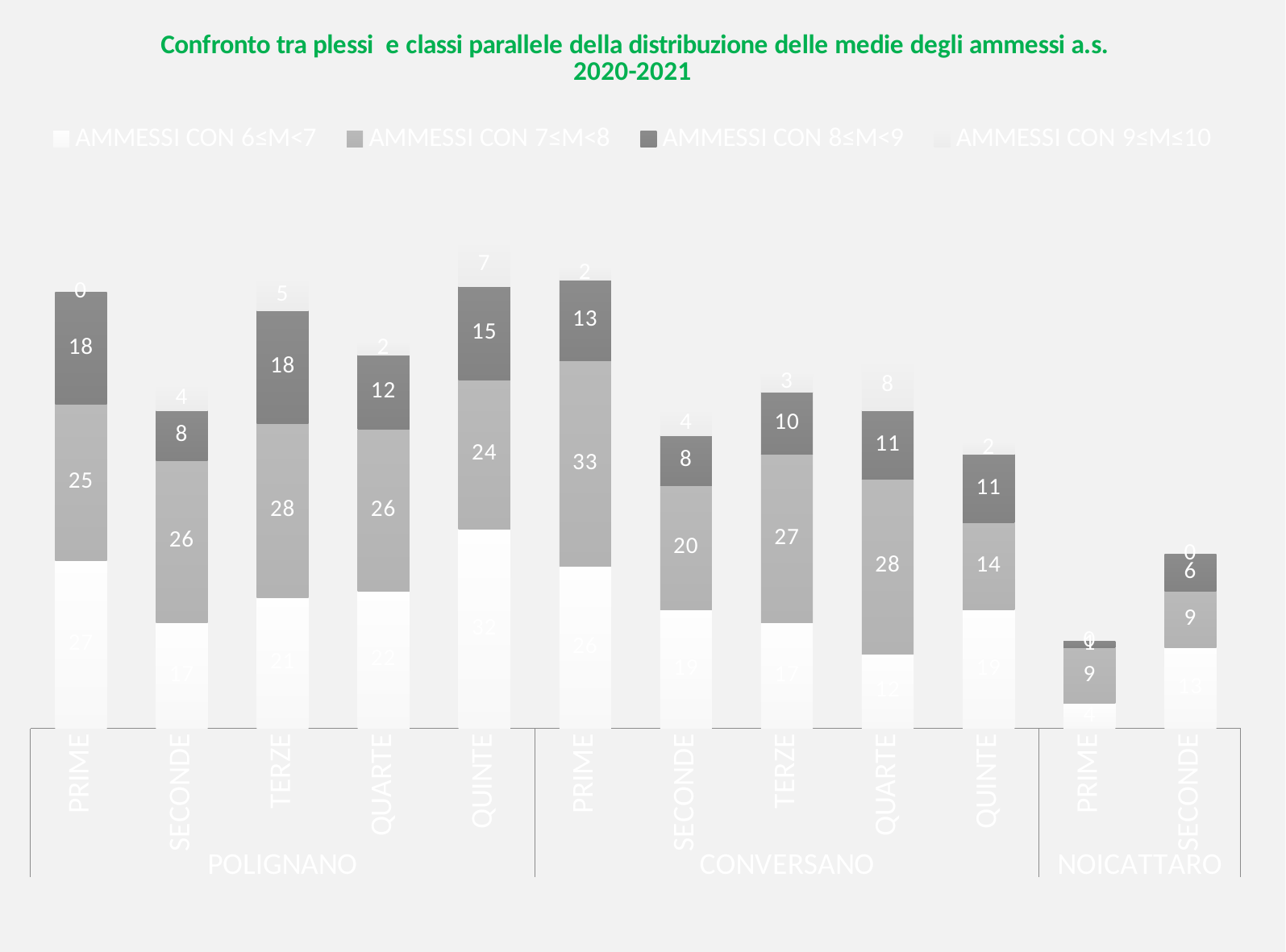
Which bar has the lowest total in the chart? PRIME in NOICATTARO In the CONVERSANO group, what is the value of AMMESSI CON 7≤M<8 for PRIME? 33 In the POLIGNANO group, what is the value of AMMESSI CON 9≤M≤10 for QUINTE? 7 In the NOICATTARO group, what is the value of AMMESSI CON 8≤M<9 for SECONDE? 6 In the CONVERSANO group, what is the value of AMMESSI CON 8≤M<9 for QUARTE? 11 What is the difference between the AMMESSI CON 8≤M<9 value for TERZE in POLIGNANO and for TERZE in CONVERSANO? 8 How many series does the legend list? 4 In the POLIGNANO group, what is the value of AMMESSI CON 7≤M<8 for TERZE? 28 How many stacked bars are shown in the chart? 12 Which has the larger AMMESSI CON 7≤M<8 value: SECONDE in POLIGNANO or SECONDE in CONVERSANO? SECONDE in POLIGNANO What kind of chart is shown on the slide? Stacked bar chart What is the total of the stacked bar for PRIME in the POLIGNANO group? 70